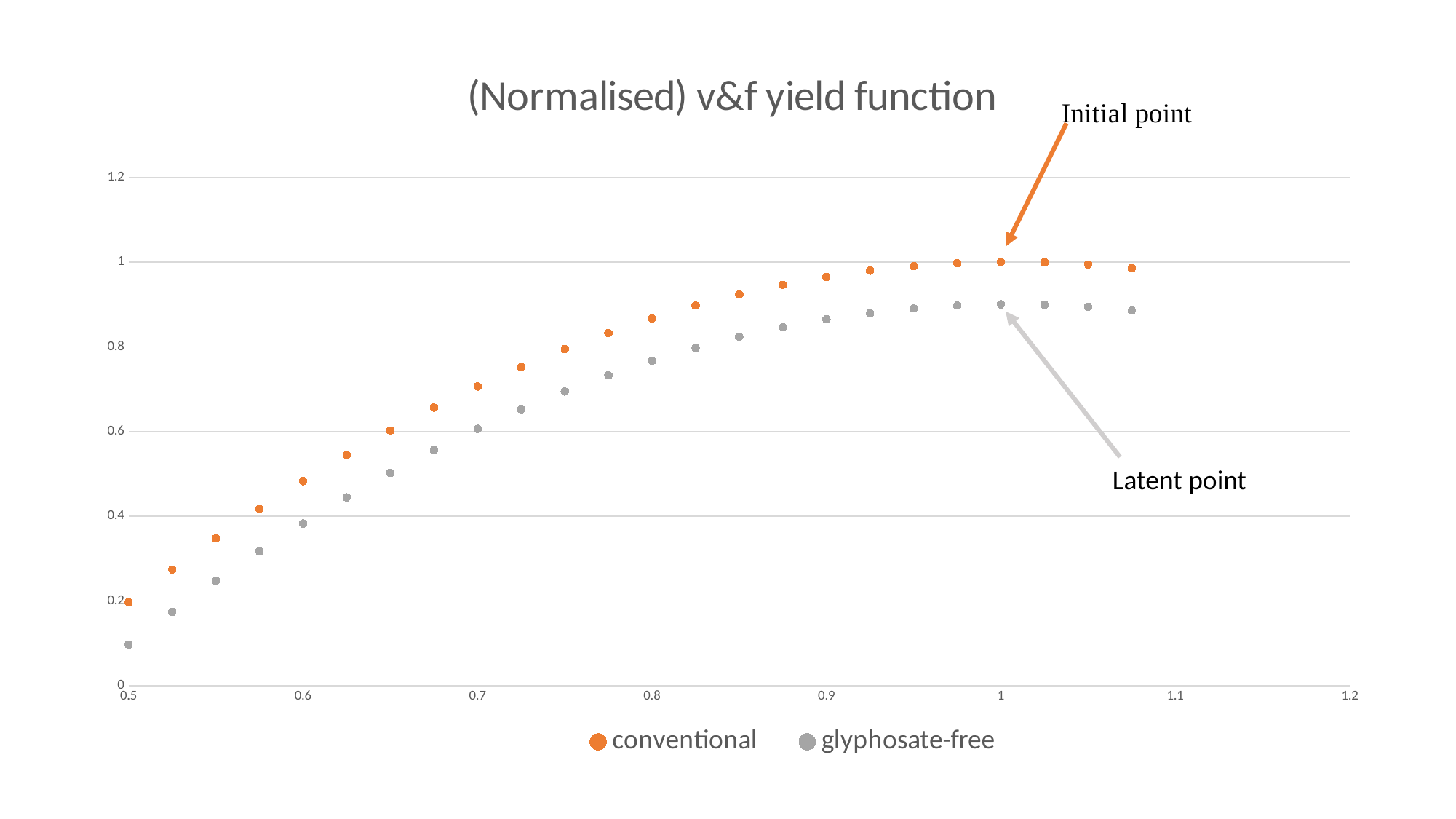
Which series is plotted in orange? conventional What is the value of the conventional series at x = 1 (the point marked 'Initial point')? 1 Do the values of the glyphosate-free series rise or fall as x increases from 0.5 to 1? rise Is the value of the conventional series at x = 0.7 greater or less than 0.6? greater How many series does the legend list? 2 At x = 0.7, which series has the higher value, conventional or glyphosate-free? conventional What kind of chart is shown on the slide? scatter chart Is the value of the conventional series at x = 0.9 greater or less than 1? less What is the title of the chart? (Normalised) v&f yield function Is the value of the glyphosate-free series at x = 0.5 greater or less than 0.2? less